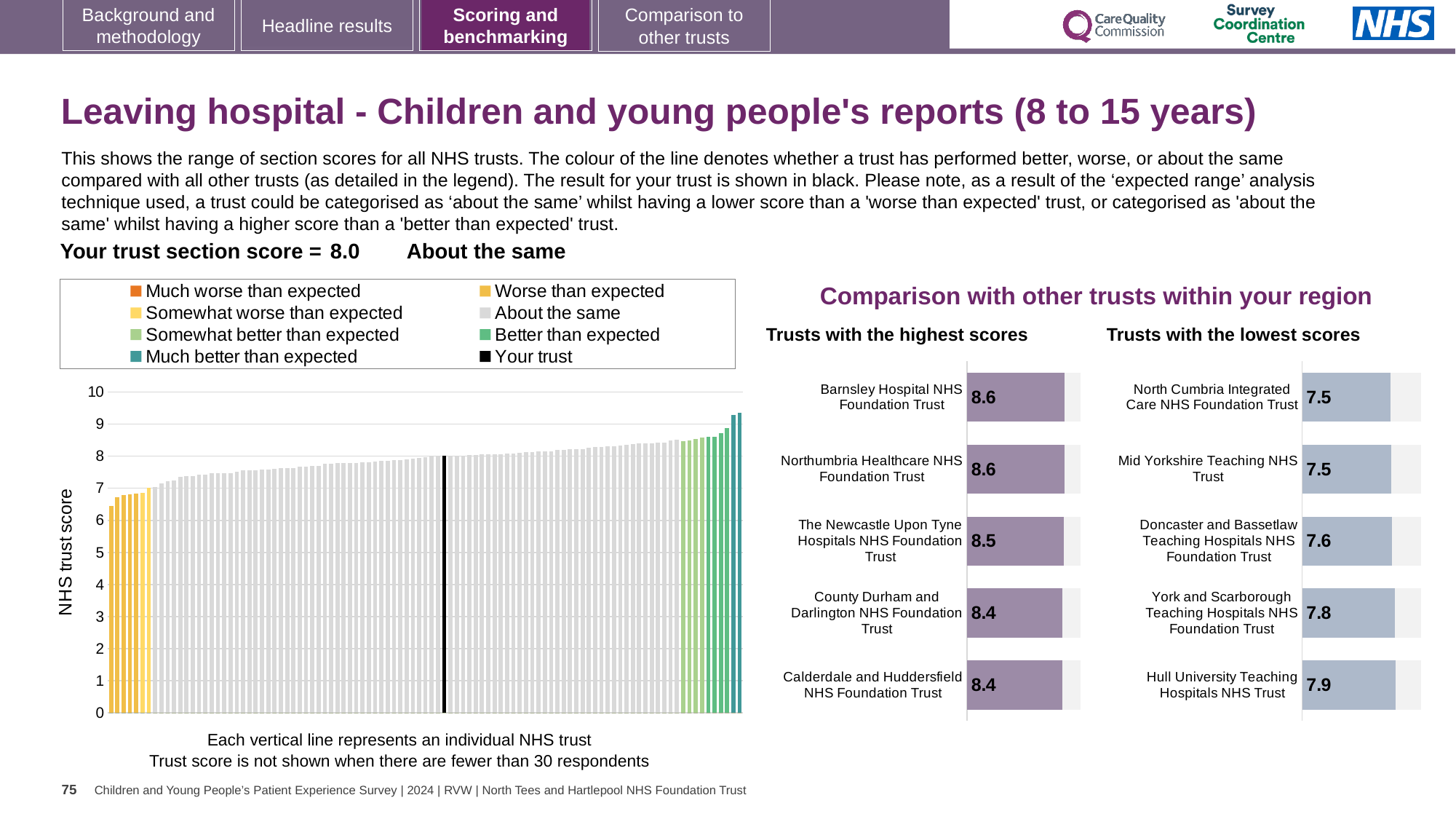
What kind of chart is the main chart on the left showing NHS trust scores? Bar chart What is the title of the section containing the two charts on the right of the slide? Comparison with other trusts within your region What is the section score for your trust shown on the slide? 8.0 In the main NHS trust score chart, do the values rise or fall from left to right? Rise How many trusts are shown in the 'Trusts with the highest scores' chart? 5 In the 'Trusts with the highest scores' chart, what is the score for Barnsley Hospital NHS Foundation Trust? 8.6 In the 'Trusts with the lowest scores' chart, which trust has the highest score? Hull University Teaching Hospitals NHS Trust In the 'Trusts with the highest scores' chart, what is the difference between the scores of Barnsley Hospital NHS Foundation Trust and Calderdale and Huddersfield NHS Foundation Trust? 0.2 In the 'Trusts with the lowest scores' chart, which has the higher score: Doncaster and Bassetlaw Teaching Hospitals NHS Foundation Trust or York and Scarborough Teaching Hospitals NHS Foundation Trust? York and Scarborough Teaching Hospitals NHS Foundation Trust In the 'Trusts with the lowest scores' chart, what is the score for Hull University Teaching Hospitals NHS Trust? 7.9 In the 'Trusts with the lowest scores' chart, what is the difference between the scores of Hull University Teaching Hospitals NHS Trust and North Cumbria Integrated Care NHS Foundation Trust? 0.4 How many entries does the legend of the main NHS trust score chart list? 8